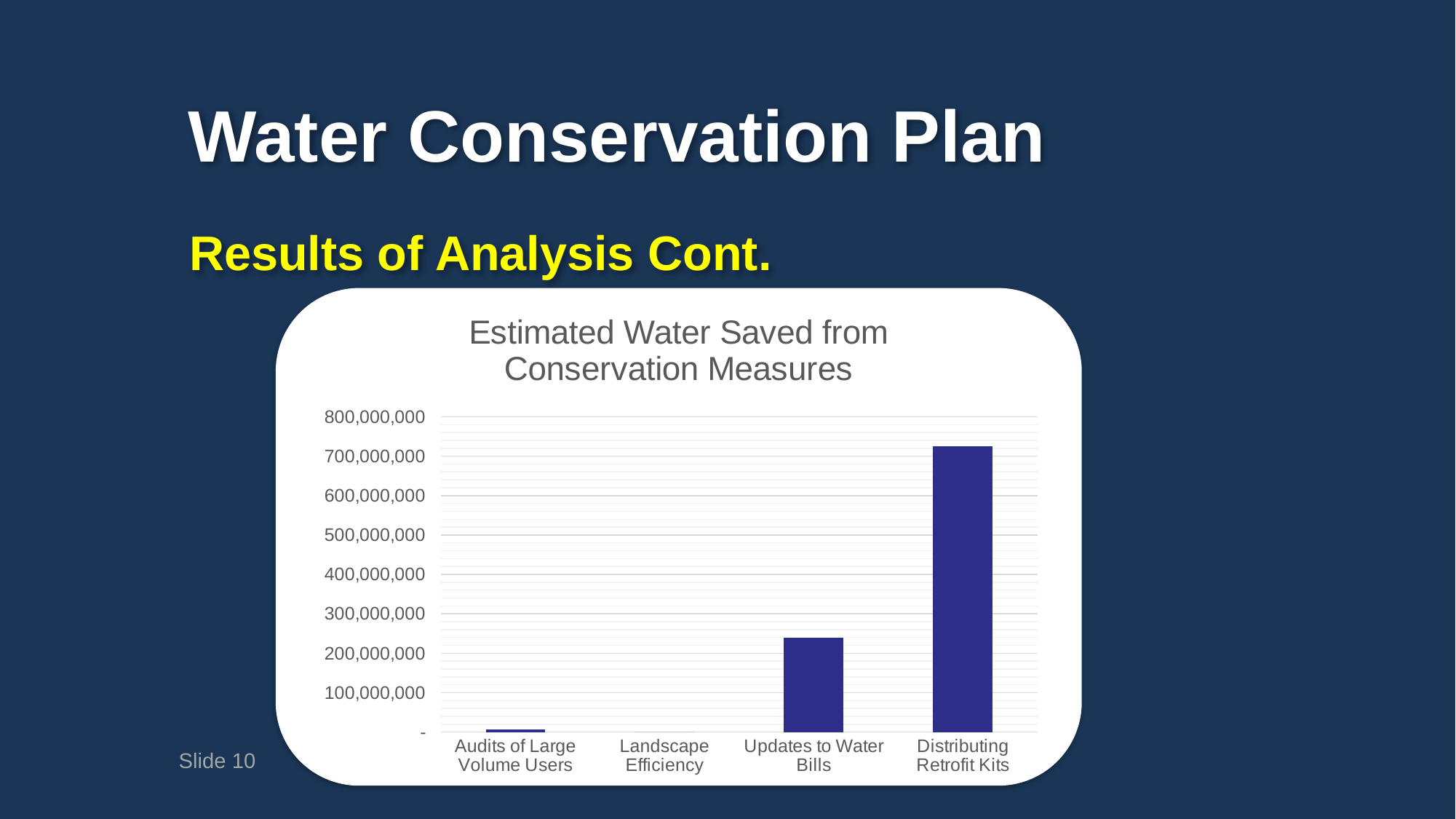
Is the value for Audits of Large Volume Users greater or less than 100,000,000? less Which conservation measure has the highest estimated water saved? Distributing Retrofit Kits What kind of chart is shown on the slide? bar chart Is the value for Distributing Retrofit Kits greater or less than 700,000,000? greater How many conservation measures (categories) are shown on the x axis? 4 What is the title of the chart? Estimated Water Saved from Conservation Measures What is the highest value labelled on the vertical axis? 800,000,000 Which conservation measure has the lowest estimated water saved? Landscape Efficiency Which is larger: the value for Distributing Retrofit Kits or the value for Updates to Water Bills? Distributing Retrofit Kits Is the value for Updates to Water Bills greater or less than 300,000,000? less Which is larger: the value for Updates to Water Bills or the value for Audits of Large Volume Users? Updates to Water Bills